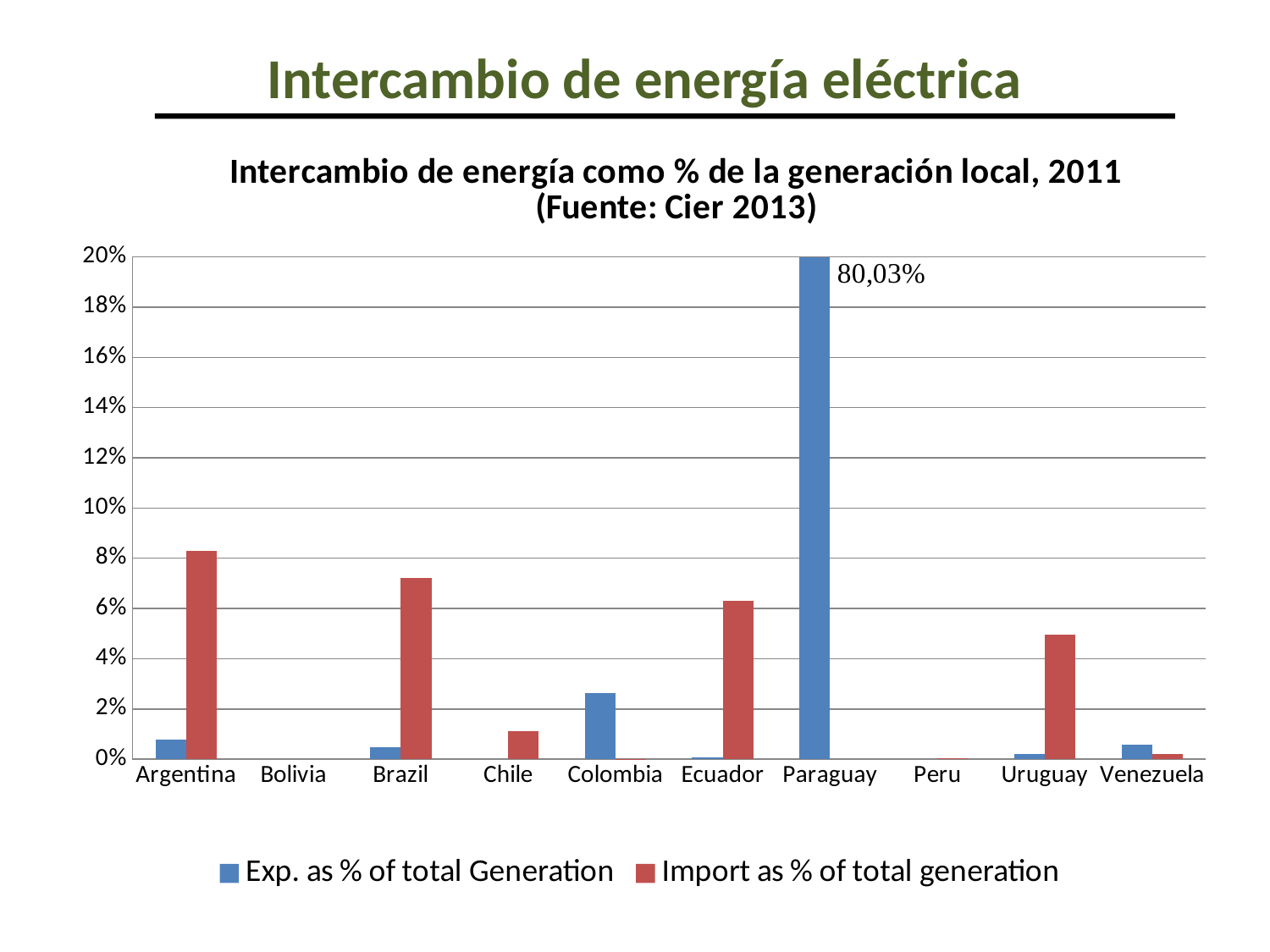
What is the export value (Exp. as % of total Generation) labelled for Paraguay? 80,03% Is the Import as % of total generation value for Brazil greater or less than 6%? greater Which country has the highest value for Exp. as % of total Generation? Paraguay Which has the larger Import as % of total generation value, Argentina or Brazil? Argentina Is the Exp. as % of total Generation value for Colombia greater or less than 2%? greater How many series does the legend list? 2 Is the Import as % of total generation value for Ecuador greater or less than 8%? less How many countries are shown on the x axis of the chart? 10 What are the two series listed in the chart legend? Exp. as % of total Generation; Import as % of total generation What kind of chart is shown on the slide? bar chart Which country has the highest value for Import as % of total generation? Argentina